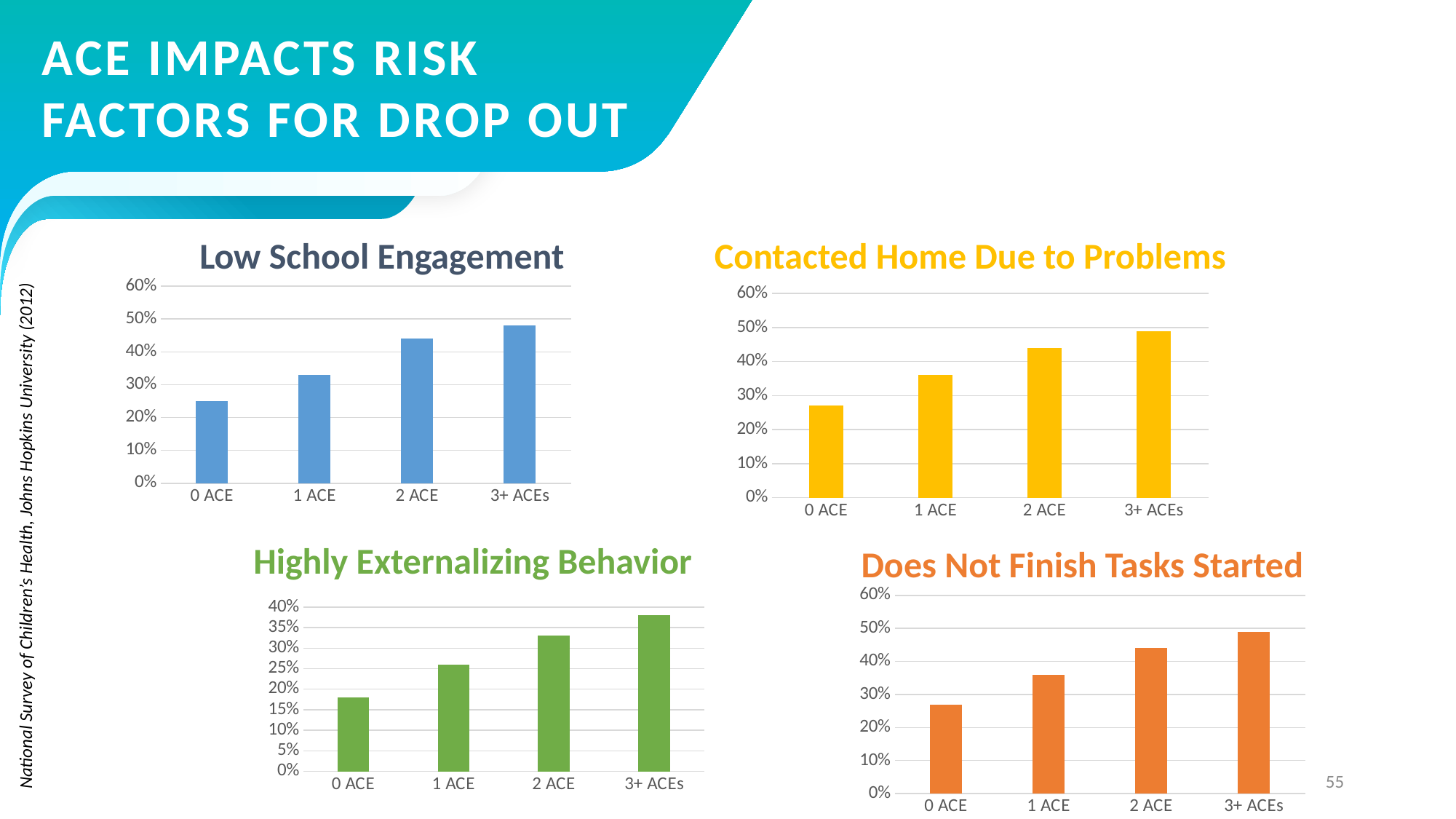
In the Low School Engagement chart, how many categories are shown on the x axis? 4 In the Contacted Home Due to Problems chart, is the value for 1 ACE greater or less than 30%? greater In the Highly Externalizing Behavior chart, do the values rise or fall from 0 ACE to 3+ ACEs? rise In the Contacted Home Due to Problems chart, which category has the lowest value? 0 ACE In the Does Not Finish Tasks Started chart, is the value for 2 ACE greater or less than 40%? greater In the Low School Engagement chart, which is larger, the value for 1 ACE or the value for 2 ACE? 2 ACE What is the title of the chart with orange bars? Does Not Finish Tasks Started In the Low School Engagement chart, which category has the highest value? 3+ ACEs How many charts are shown on the slide? 4 In the Low School Engagement chart, is the value for 0 ACE greater or less than 20%? greater What type of chart is the Low School Engagement chart? bar chart